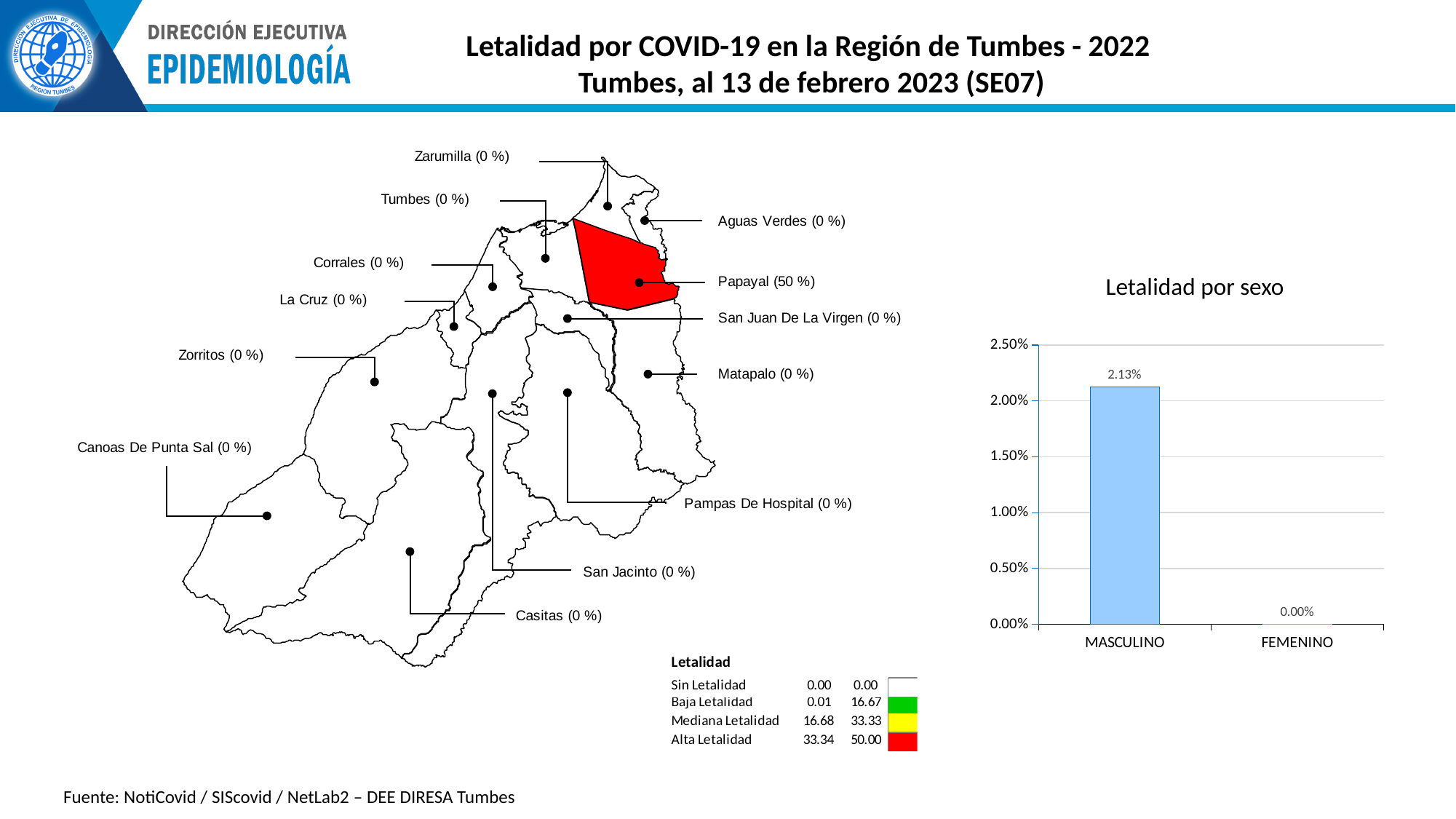
In the 'Letalidad por sexo' chart, how many categories are shown on the x axis? 2 On the map on the left, which district is shown with a lethality of 50 %? Papayal In the 'Letalidad por sexo' chart, is the value for MASCULINO greater or less than 2.00%? greater In the 'Letalidad por sexo' chart, what is the value for FEMENINO? 0.00% In the 'Letalidad por sexo' chart, what is the difference between the MASCULINO and FEMENINO values? 2.13% In the 'Letalidad por sexo' chart, which category has the highest value? MASCULINO In the 'Letalidad por sexo' chart, what is the highest value shown on the y axis? 2.50% In the map legend, what colour represents 'Alta Letalidad'? red What kind of chart is 'Letalidad por sexo'? bar chart In the 'Letalidad por sexo' chart, what is the value for MASCULINO? 2.13% On the map on the left, what lethality value is shown for Zorritos? 0 % In the 'Letalidad por sexo' chart, which category has the lowest value? FEMENINO